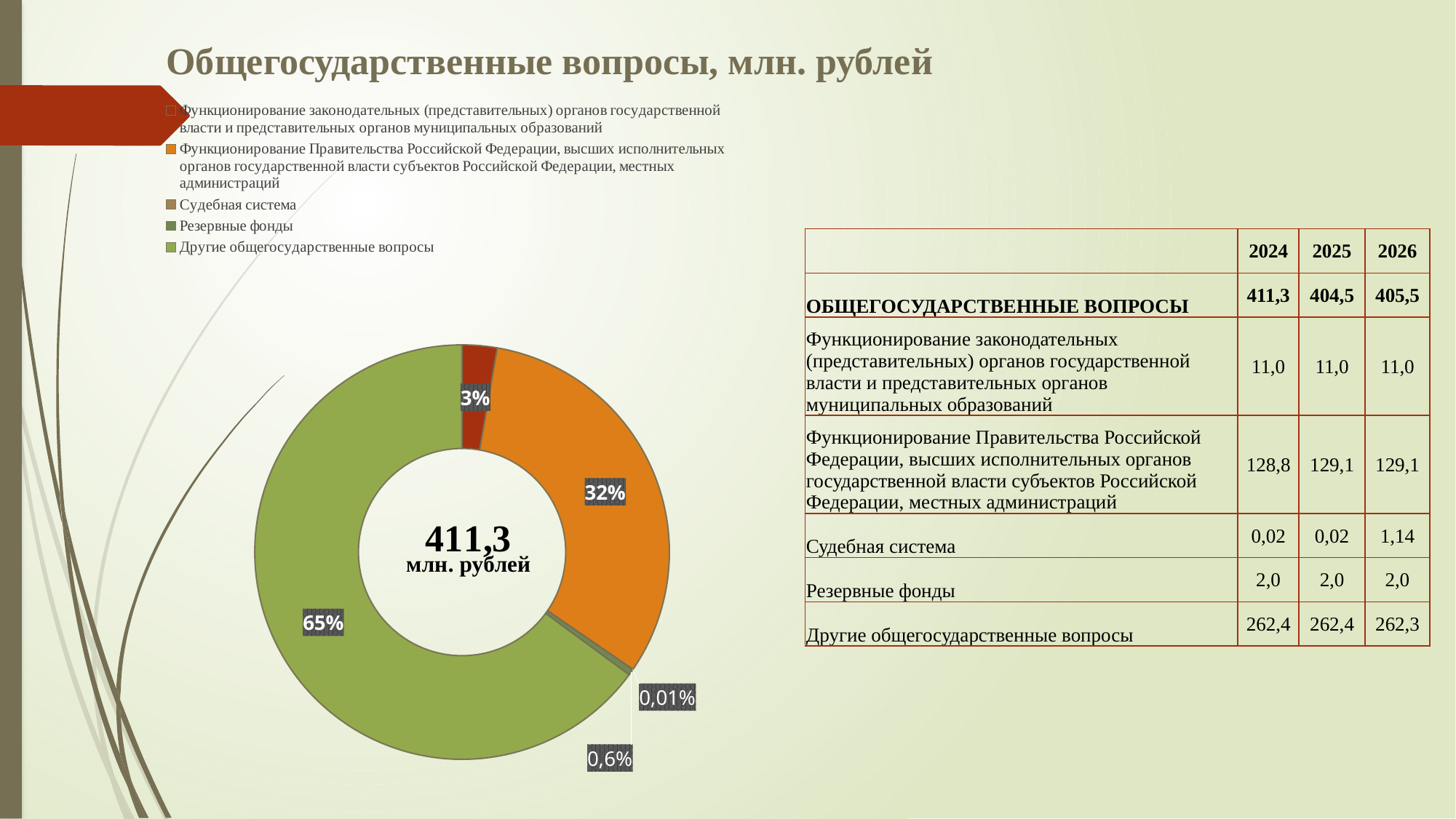
What percentage is shown for "Функционирование законодательных (представительных) органов государственной власти и представительных органов муниципальных образований" in the doughnut chart? 3% Which category has the largest share in the doughnut chart? Другие общегосударственные вопросы What total value is printed in the centre of the doughnut chart? 411,3 млн. рублей What is the difference in percentage points between the "Другие общегосударственные вопросы" slice and the "Функционирование Правительства Российской Федерации..." slice? 33 percentage points What kind of chart is shown on the slide? Doughnut (pie) chart Which category has the smallest share in the doughnut chart? Судебная система What percentage is shown for "Функционирование Правительства Российской Федерации, высших исполнительных органов государственной власти субъектов Российской Федерации, местных администраций" in the doughnut chart? 32% What percentage is shown for "Судебная система" in the doughnut chart? 0,01% What share of the doughnut chart does "Другие общегосударственные вопросы" take? 65% How many entries does the legend of the doughnut chart list? 5 What percentage is shown for "Резервные фонды" in the doughnut chart? 0,6% How many slices does the doughnut chart have? 5